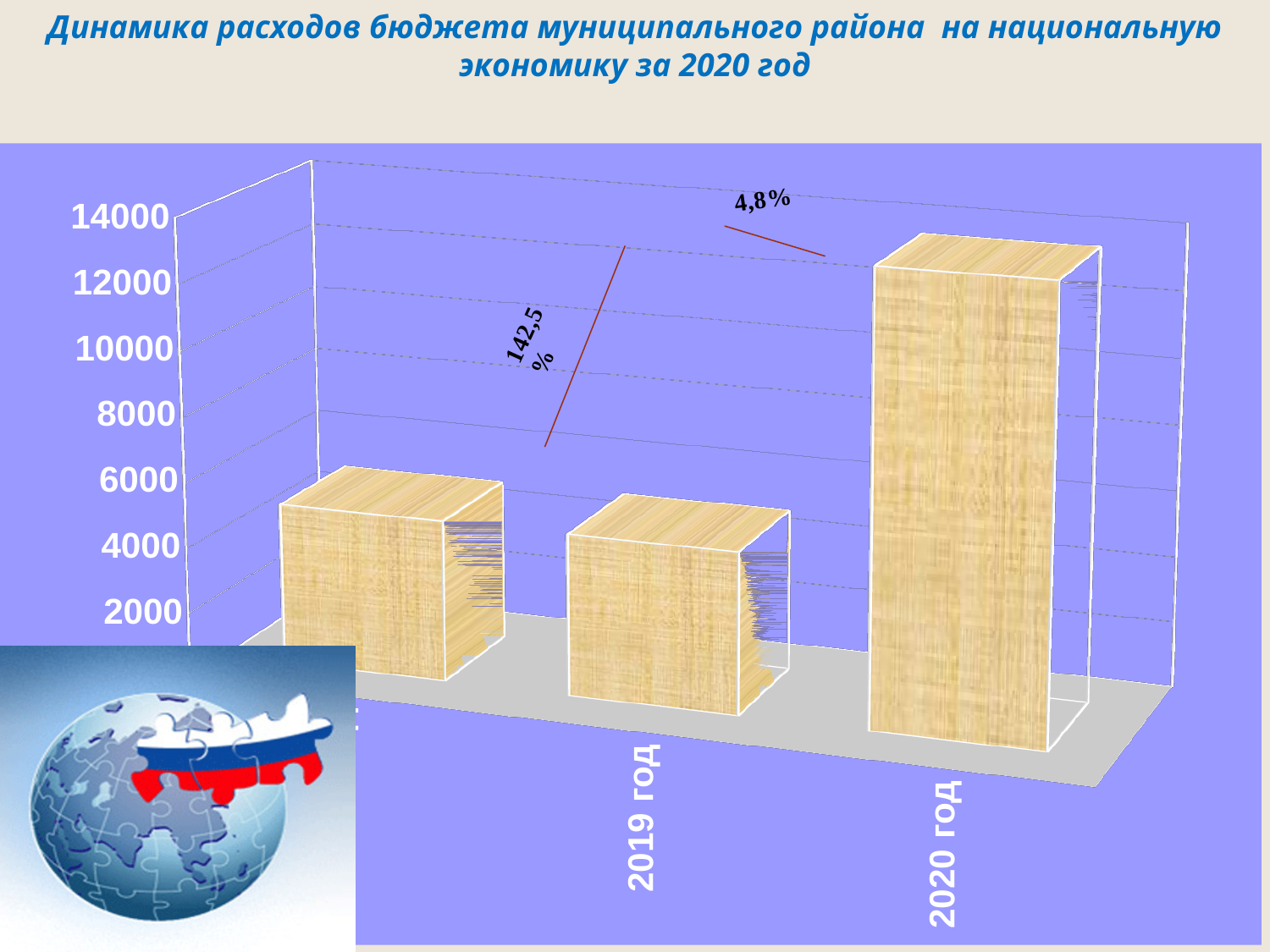
What is the title of the chart on the slide? Динамика расходов бюджета муниципального района на национальную экономику за 2020 год Does the value rise or fall from 2019 год to 2020 год? rise Is the value for 2020 год greater or less than 14000? less How many bars are plotted in the chart? 3 Which year has the highest bar in the chart? 2020 год What percentage annotation is written above the 2020 год bar? 4,8% Which is larger, the value for 2019 год or the value for 2020 год? 2020 год Is the value for 2019 год greater or less than 8000? less Is the value for 2020 год greater or less than 10000? greater What kind of chart is shown on the slide? bar chart